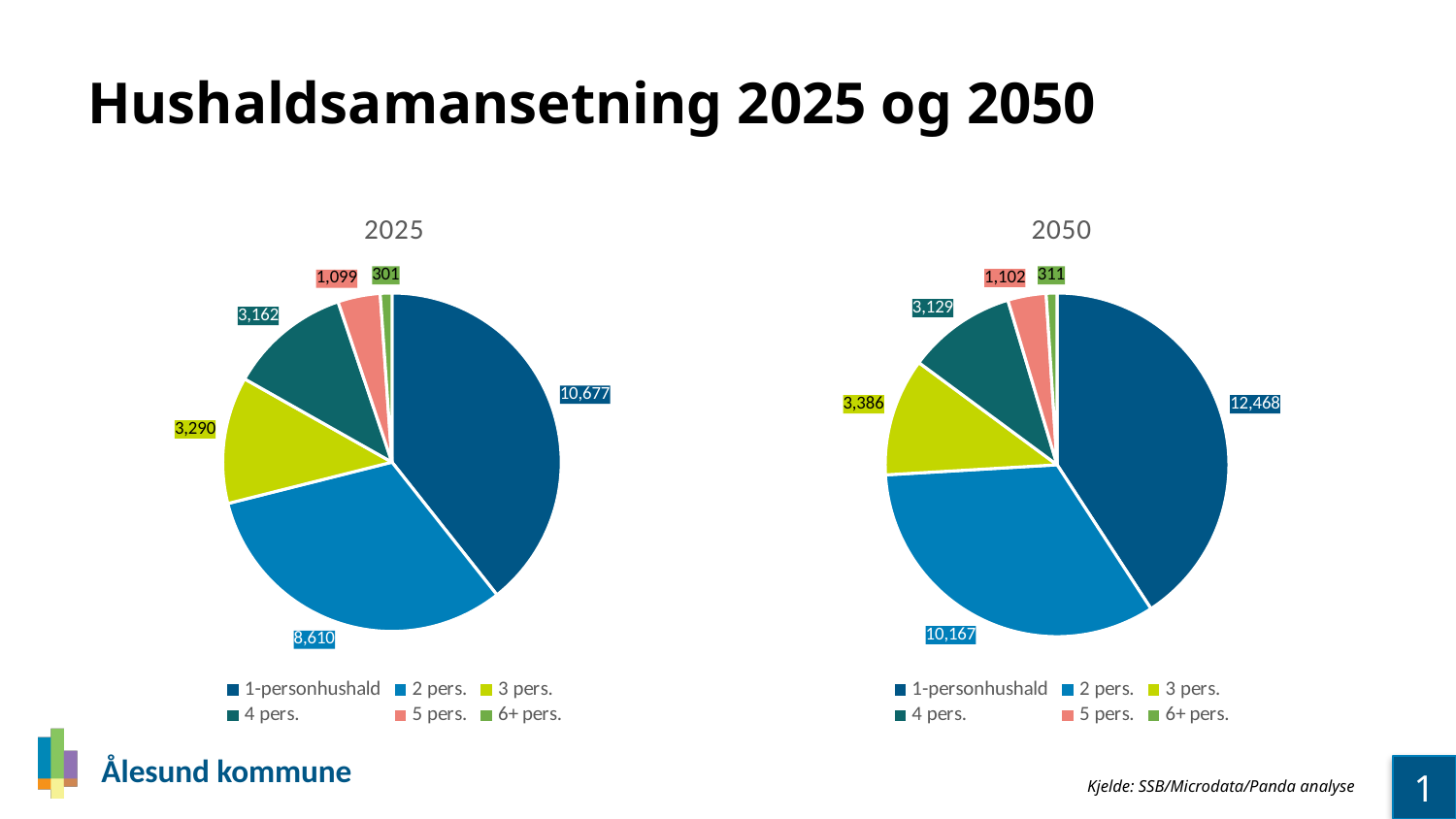
In the 2050 chart, which is larger: 3 pers. or 4 pers.? 3 pers. In the 2025 chart, what is the value for 1-personhushald? 10,677 In the 2025 chart, which category has the smallest slice? 6+ pers. What is the difference between the 1-personhushald value in the 2050 chart and in the 2025 chart? 1,791 How many categories does the legend of the 2025 chart list? 6 In the 2050 chart, what is the value for 6+ pers.? 311 In the 2050 chart, what is the value for 2 pers.? 10,167 What is the title of the slide? Hushaldsamansetning 2025 og 2050 In the 2025 chart, what is the difference between the 2 pers. and 3 pers. values? 5,320 What kind of chart is the 2050 chart? Pie chart In the 2050 chart, which category has the largest slice? 1-personhushald In the 2025 chart, what is the value for 4 pers.? 3,162